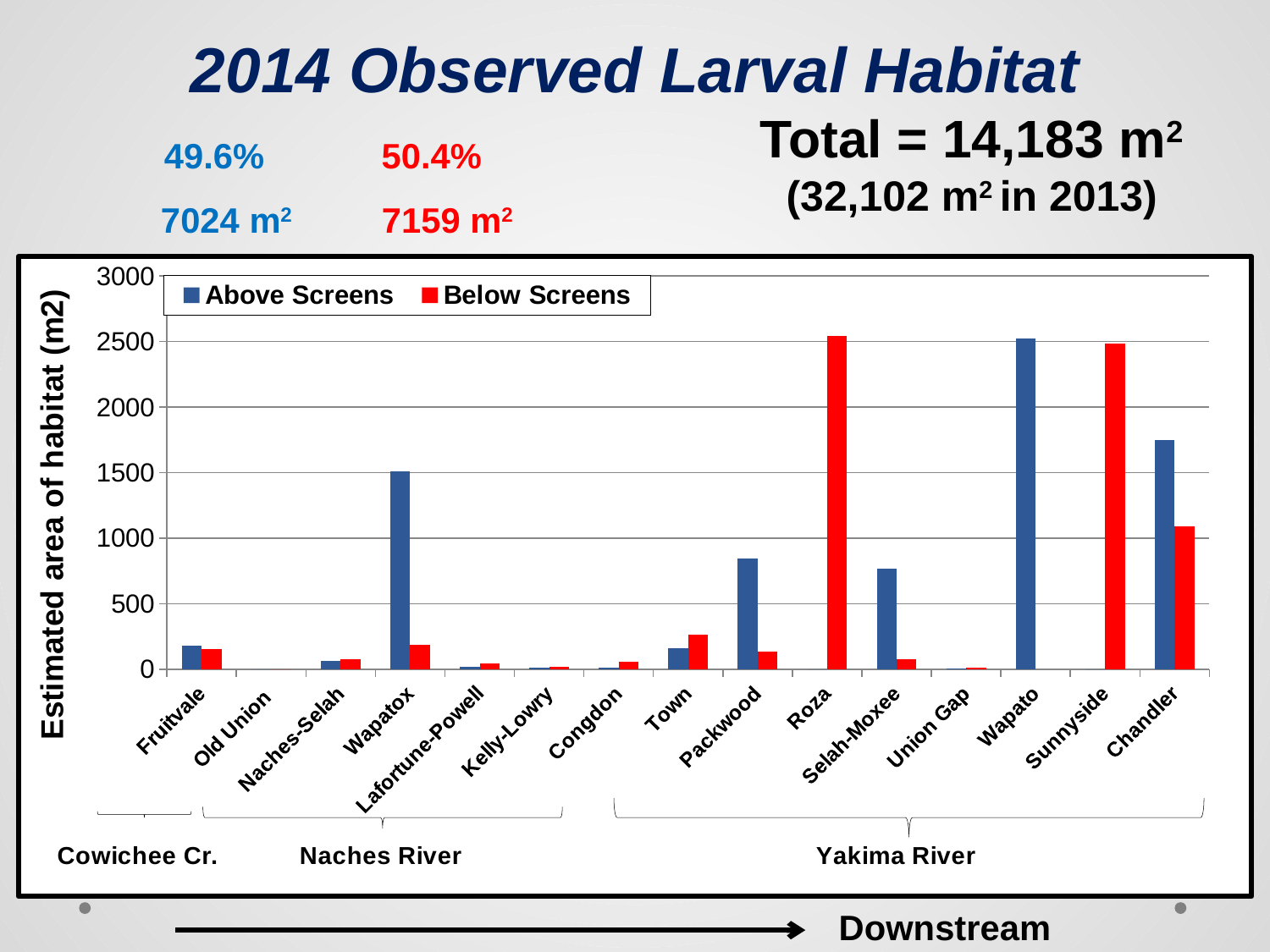
Is the Above Screens value for Wapatox greater or less than 1000? greater What kind of chart is shown on the slide? bar chart Which site has the highest Above Screens value? Wapato How many sites (categories) are shown along the x axis of the chart? 15 Which colour represents the Below Screens series in the chart? red How many series does the chart legend list? 2 At Wapatox, which is larger: the Above Screens value or the Below Screens value? Above Screens Is the Above Screens value for Chandler greater or less than 1500? greater At Roza, which is larger: the Above Screens value or the Below Screens value? Below Screens Is the Below Screens value for Sunnyside greater or less than 2000? greater What is the label of the chart's y axis? Estimated area of habitat (m2)